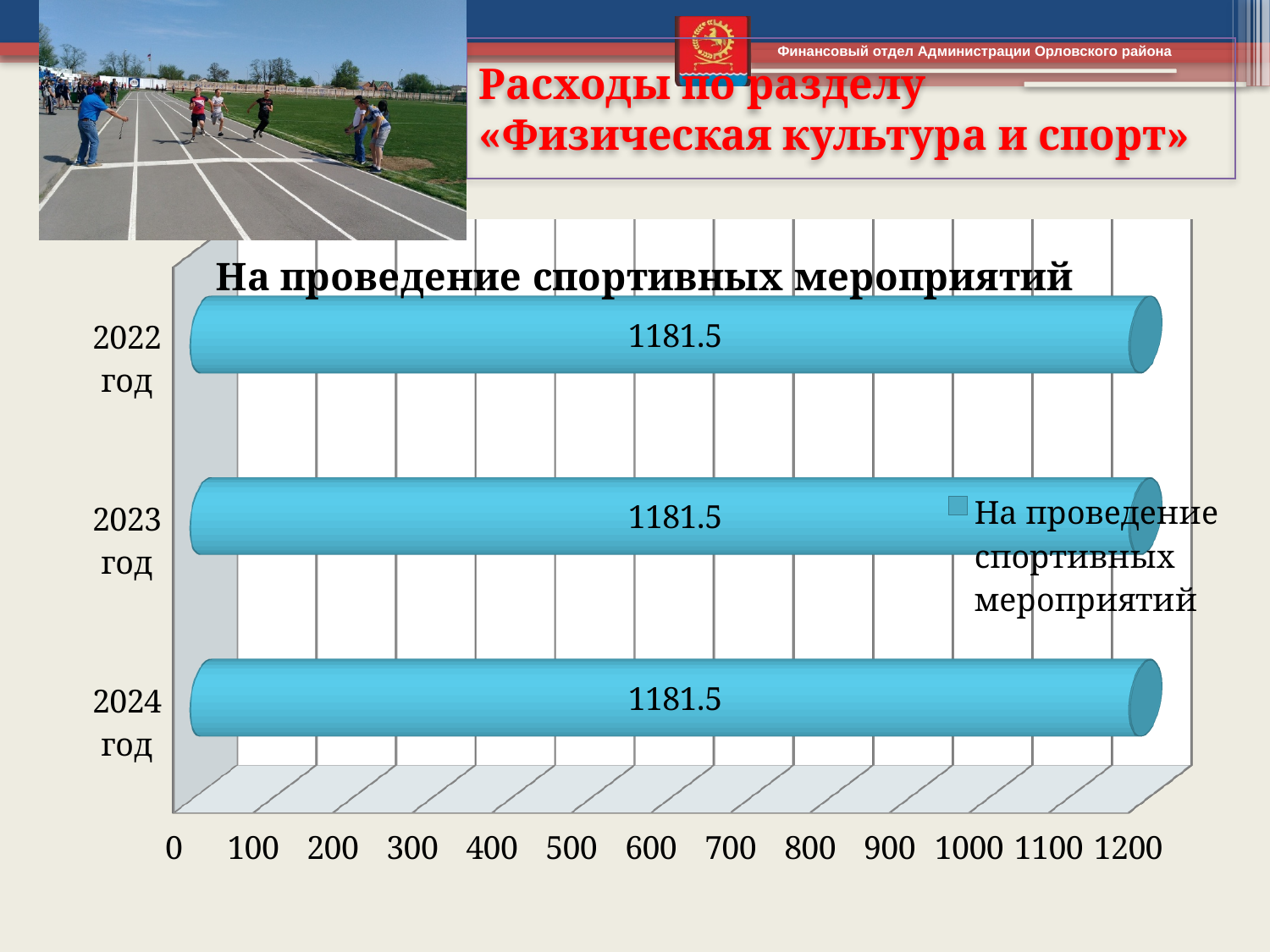
What is the highest value shown on the horizontal axis of the chart? 1200 Do the values rise, fall, or stay the same from 2022 год to 2024 год? stay the same Is the value for 2024 год greater or less than 1200? less What is the title of the chart? На проведение спортивных мероприятий What is the value for 2022 год in the chart? 1181.5 What is the value for 2024 год in the chart? 1181.5 Is the value for 2023 год greater or less than 1100? greater How many series does the legend list? 1 How many categories (years) are shown in the chart? 3 What kind of chart is shown on the slide? bar chart What is the difference between the values for 2024 год and 2022 год? 0 What is the value for 2023 год in the chart? 1181.5